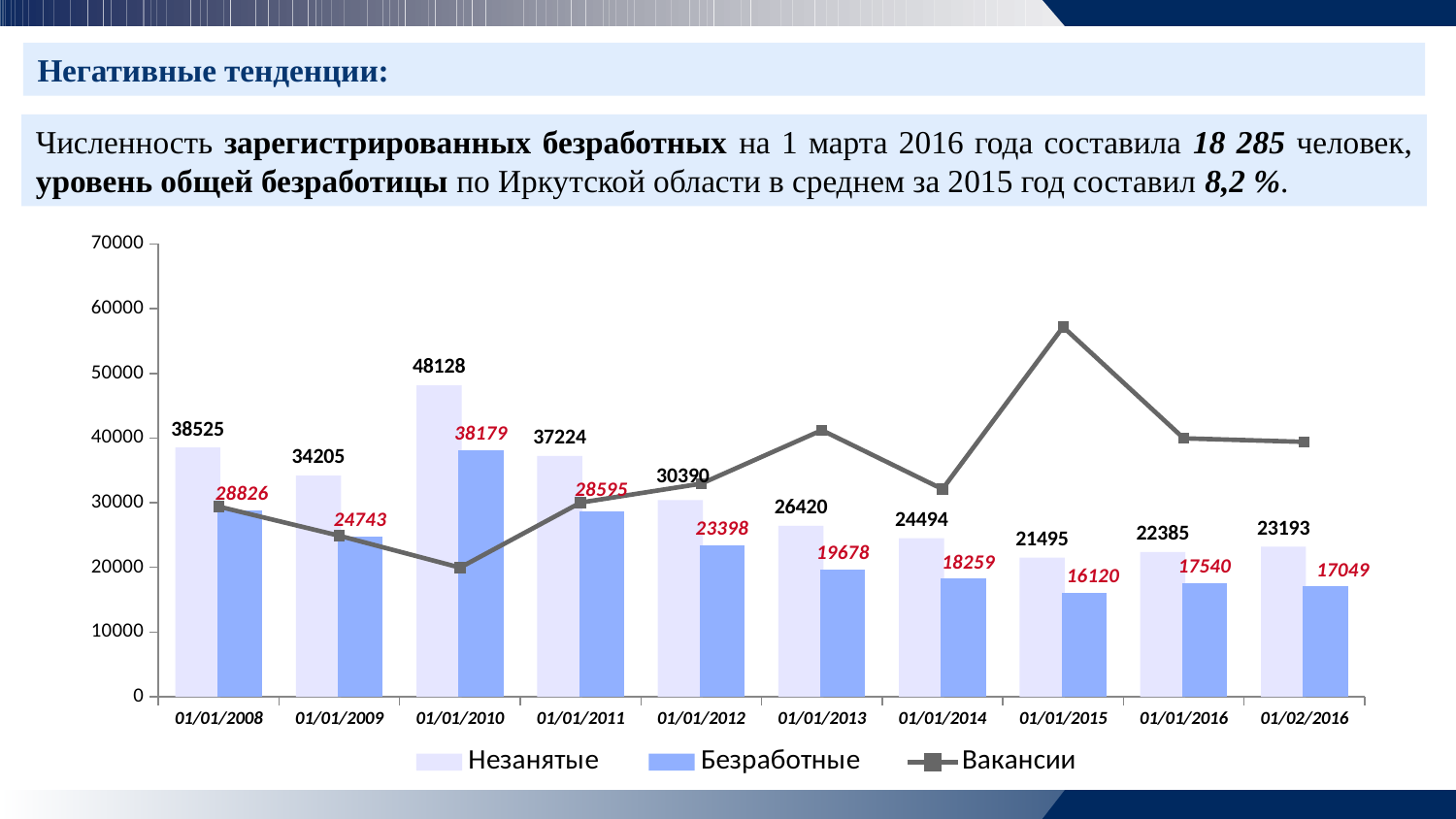
What is the difference between Незанятые and Безработные on 01/01/2008? 9699 On which date is the value of Безработные the lowest? 01/01/2015 What kind of chart is shown on the slide? bar and line chart What is the value of Незанятые on 01/01/2010? 48128 On which date is the value of Незанятые the highest? 01/01/2010 How many series does the legend list? 3 What is the value of Безработные on 01/01/2015? 16120 How many dates are shown on the x axis of the chart? 10 Is the value for Вакансии on 01/01/2010 greater or less than 30000? less Which date has the larger value of Безработные: 01/01/2016 or 01/02/2016? 01/01/2016 Do the values of Безработные rise or fall from 01/01/2010 to 01/01/2015? fall Is the value for Вакансии on 01/01/2015 greater or less than 50000? greater